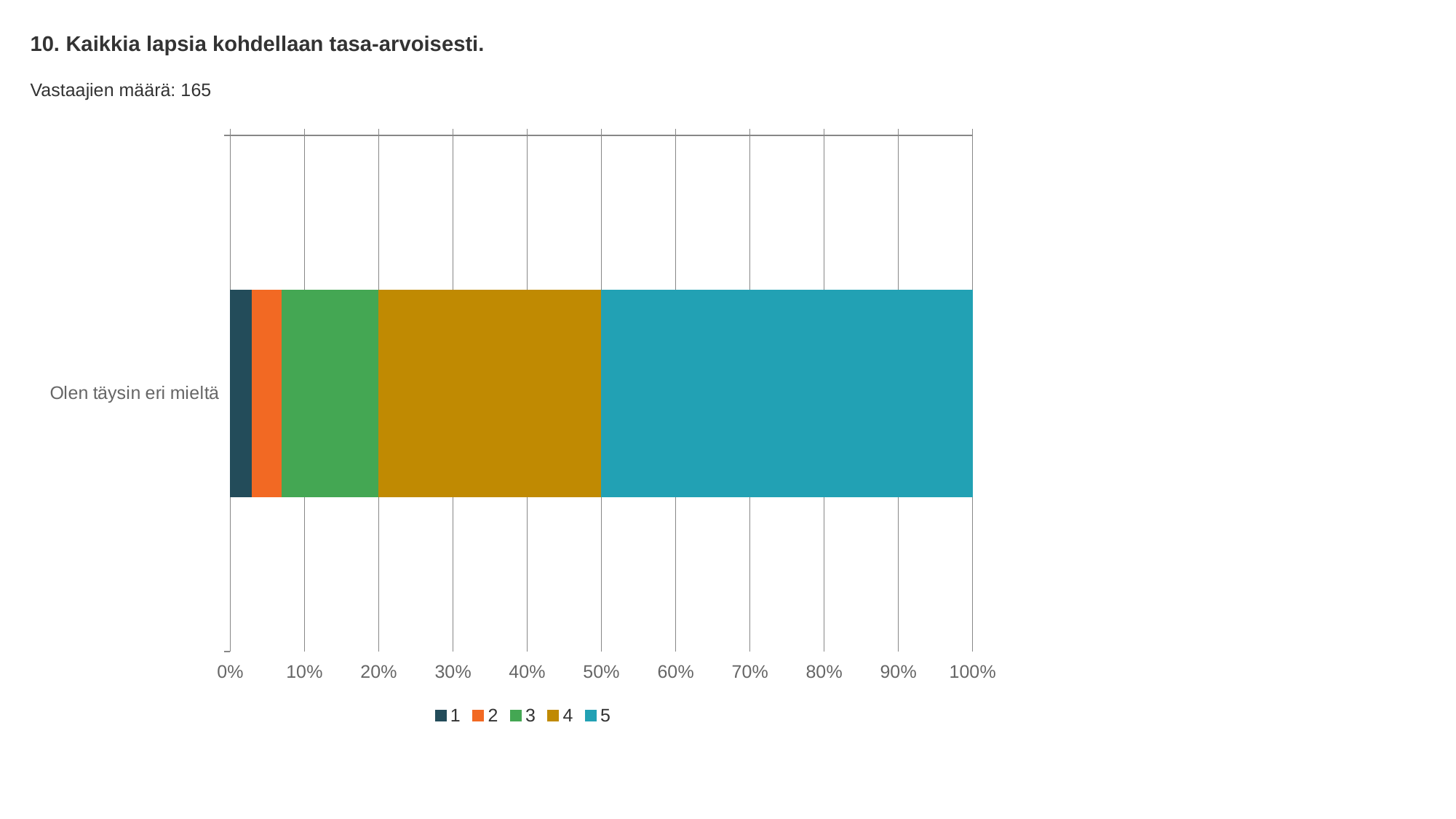
What kind of chart is shown on the slide? Stacked bar chart Is the share of series 5 greater or less than 40%? greater How many categories are plotted on the y axis? 1 Which series takes up the largest share of the bar? 5 What is the label of the category on the y axis? Olen täysin eri mieltä What is the title of the chart? 10. Kaikkia lapsia kohdellaan tasa-arvoisesti. Is the share of series 4 greater or less than 20%? greater How many series does the legend list? 5 Is the share of series 1 greater or less than 10%? less Which series takes up a larger share of the bar, 3 or 4? 4 Which series takes up a larger share of the bar, 4 or 5? 5